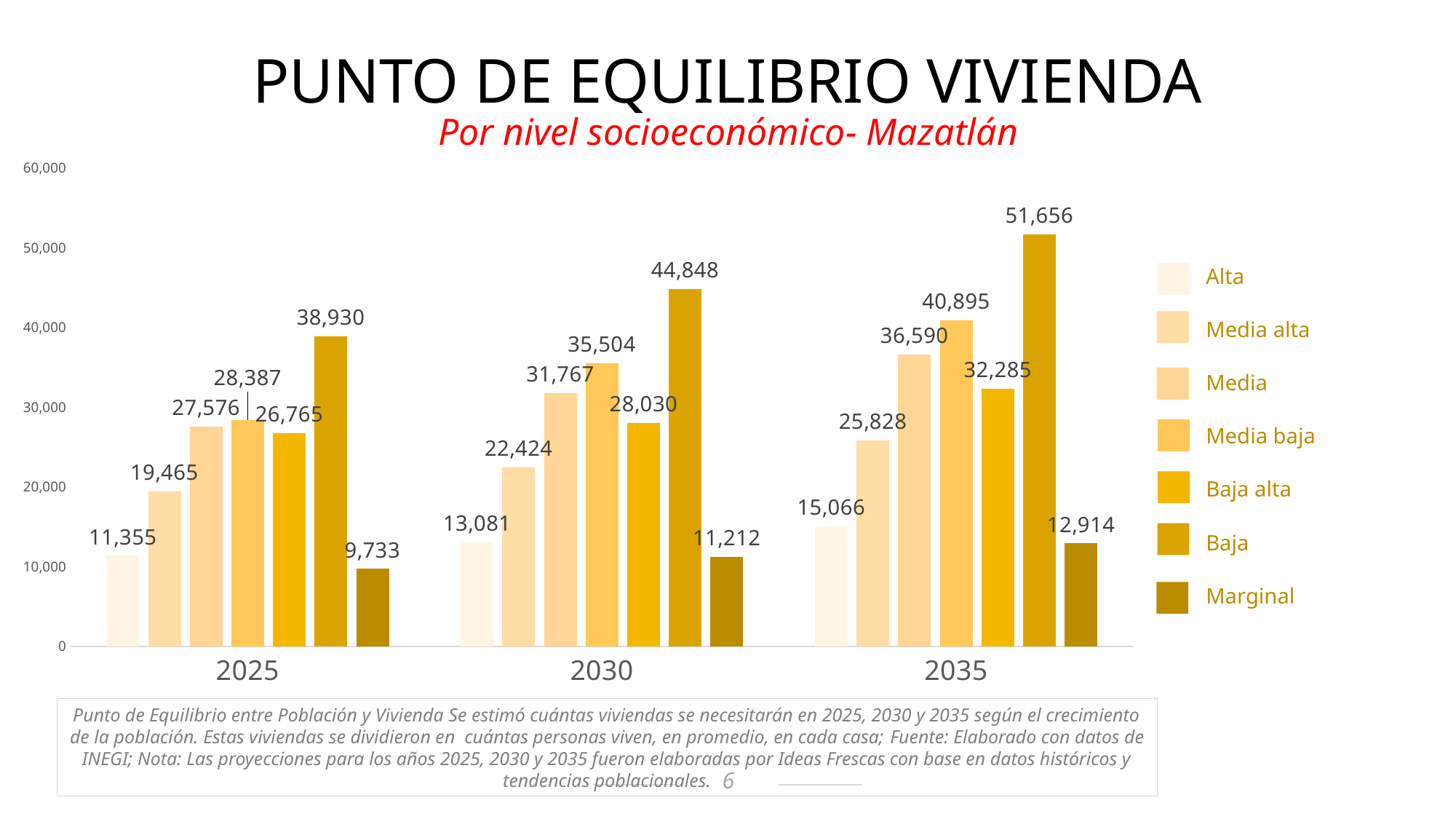
How many year categories are shown on the x axis? 3 Do the values for Media alta rise or fall from 2025 to 2035? Rise What is the value for Baja in 2035? 51,656 How many series does the legend list? 7 What is the value for Media baja in 2030? 35,504 Which series has the lowest value in 2035? Marginal What is the value for Alta in 2025? 11,355 Which is larger in 2025: Media or Baja alta? Media What is the value for Marginal in 2030? 11,212 What kind of chart is shown on the slide? Bar chart What is the difference between the Baja value in 2035 and the Baja value in 2025? 12,726 Which series has the highest value in 2030? Baja